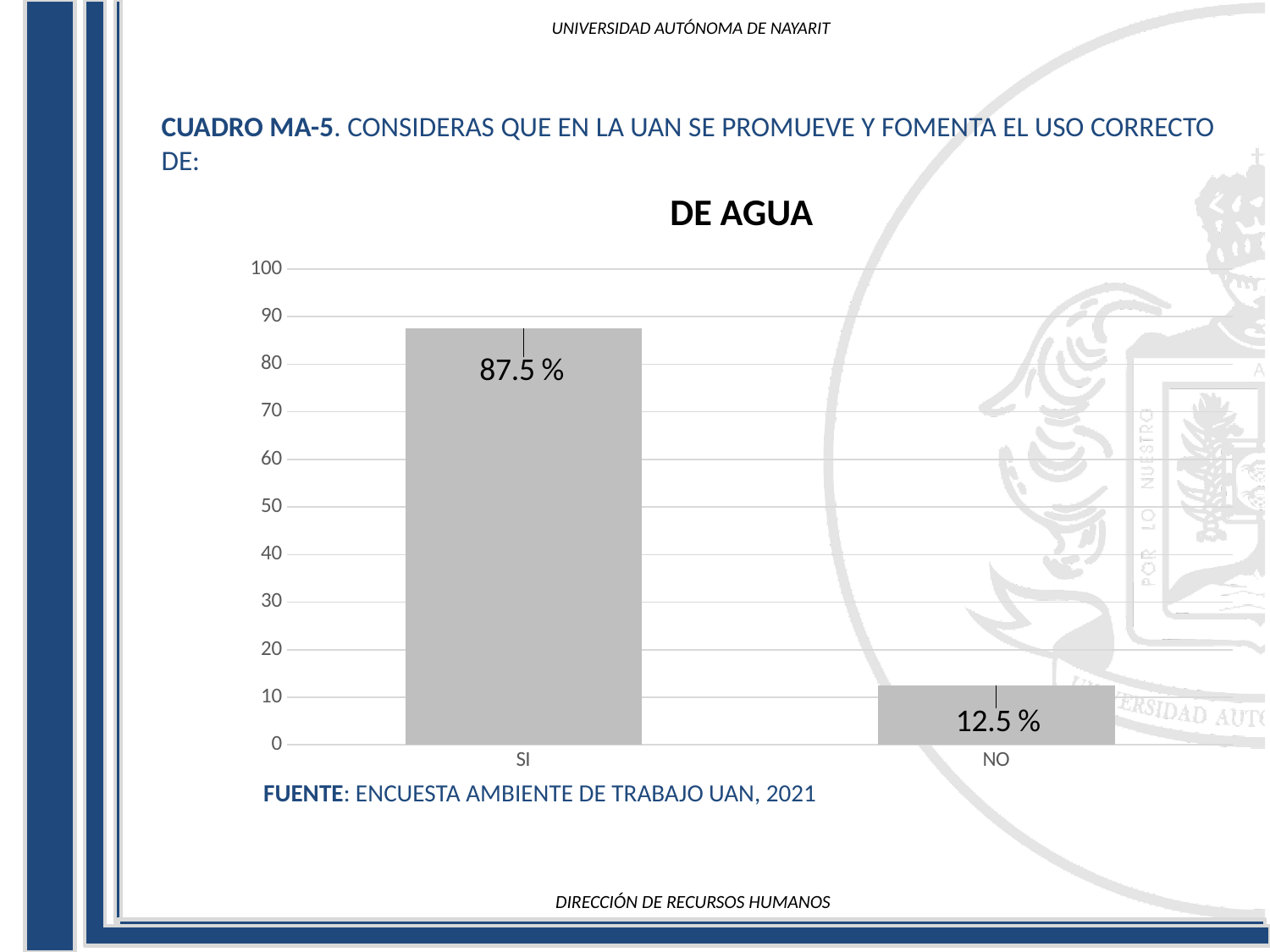
What is the value for NO? 12.5 % Which category has the lowest value? NO What kind of chart is shown on the slide? bar chart What is the difference between the values for SI and NO? 75 % How many categories are shown on the x axis? 2 Which category has the highest value? SI Is the value for SI greater or less than 80? greater What is the title of the chart? DE AGUA Is the value for NO greater or less than 20? less What is the highest value shown on the vertical axis? 100 What is the value for SI? 87.5 % Which is larger, the value for SI or the value for NO? SI